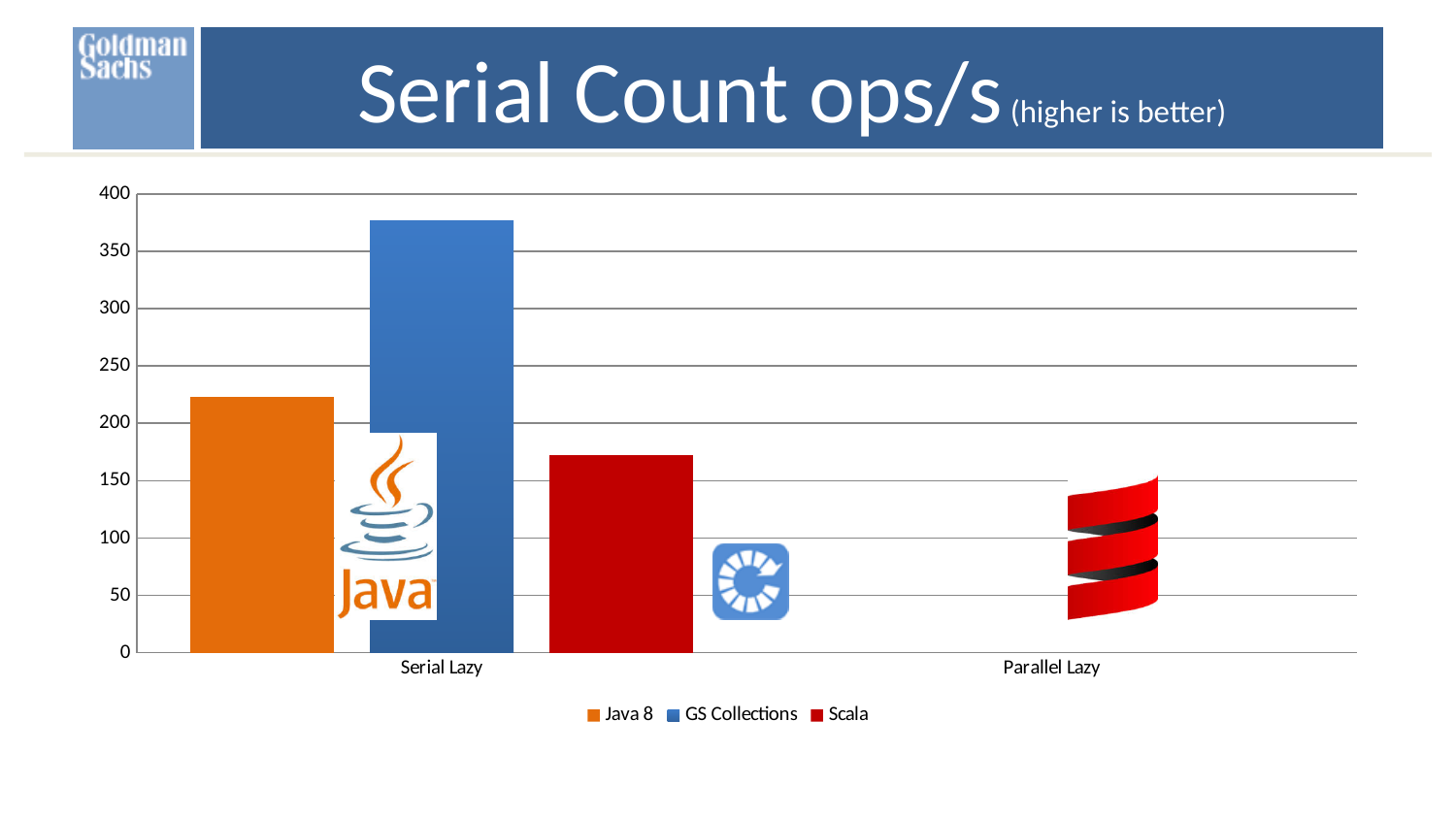
Is the Scala value for Serial Lazy greater or less than 200? less For Serial Lazy, which is larger: Java 8 or Scala? Java 8 For Serial Lazy, which is larger: GS Collections or Java 8? GS Collections What is the title of the chart? Serial Count ops/s (higher is better) Is the Java 8 value for Serial Lazy greater or less than 200? greater What kind of chart is shown on the slide? bar chart Which series has the highest value for Serial Lazy? GS Collections Which series is shown in blue in the legend? GS Collections Which series has the lowest value for Serial Lazy? Scala How many categories are labelled on the x axis? 2 How many series does the legend list? 3 Is the GS Collections value for Serial Lazy greater or less than 350? greater